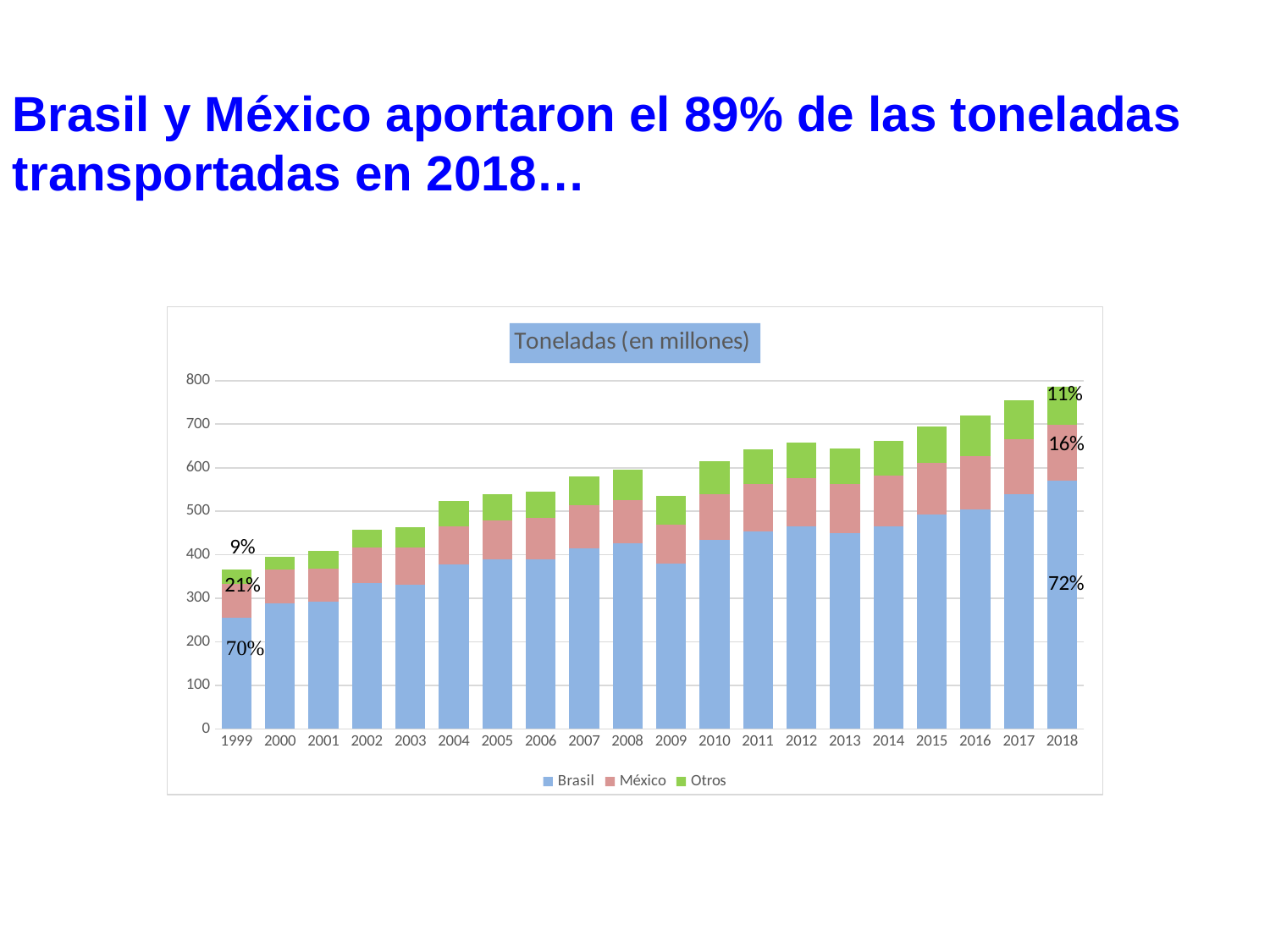
What is the title of the chart? Toneladas (en millones) Do the total values generally rise or fall from 1999 to 2018? rise Which year has the lowest total stacked bar? 1999 What percentage share is labelled for Brasil in 1999? 70% How many years are shown on the x axis? 20 Which year has the highest total stacked bar? 2018 What percentage share is labelled for Brasil in 2018? 72% Is the total value for 2018 greater or less than 700? greater What kind of chart is shown on the slide? Stacked bar chart What percentage share is labelled for Otros in 2018? 11% How many series does the legend list? 3 What percentage share is labelled for México in 1999? 21%